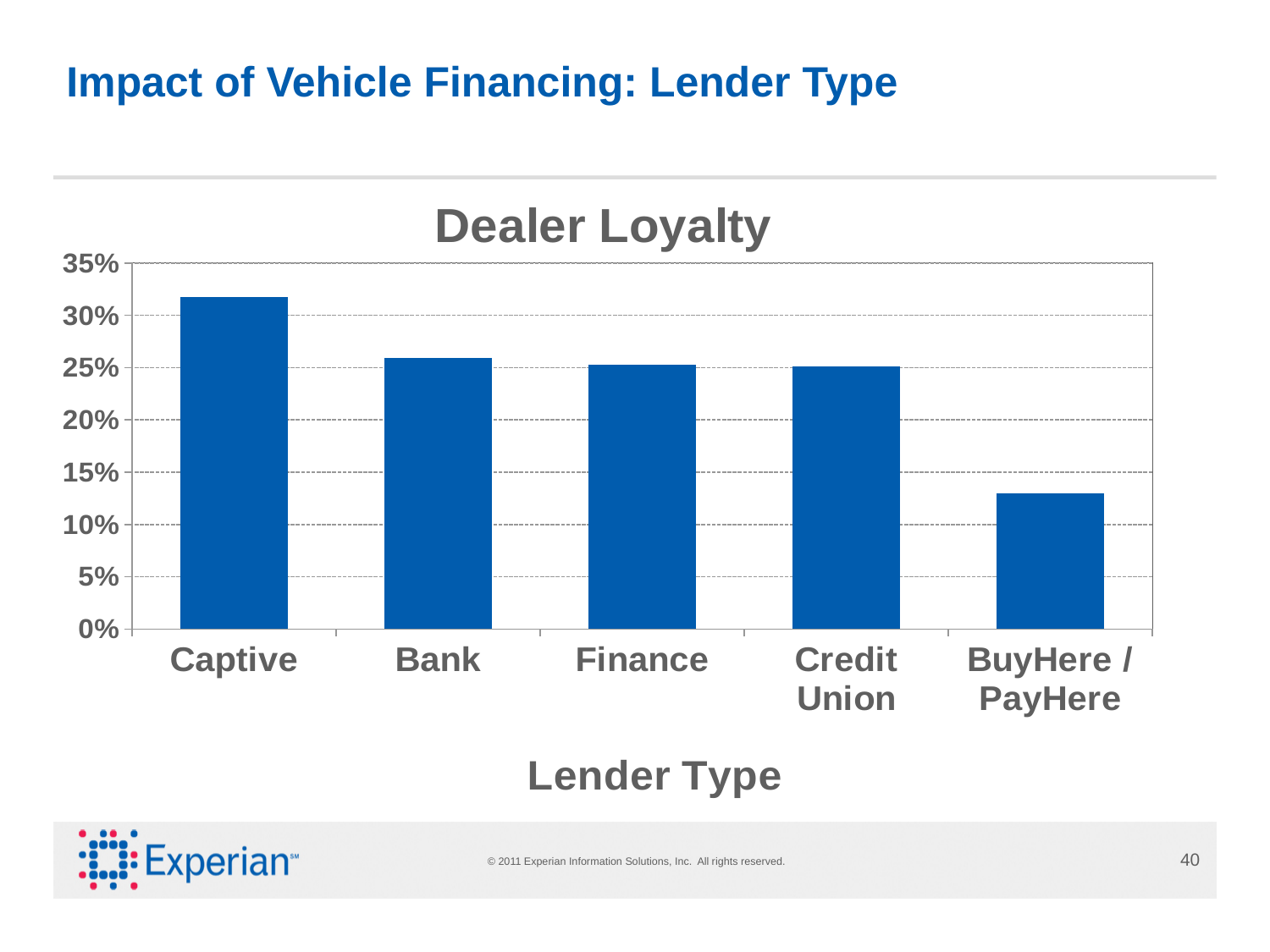
Is the value for Captive greater or less than 30%? greater Which has higher dealer loyalty, Bank or BuyHere / PayHere? Bank Which has higher dealer loyalty, Captive or Bank? Captive Which lender type has the lowest dealer loyalty? BuyHere / PayHere Which lender type has the highest dealer loyalty? Captive Do the values generally rise or fall moving from Captive to BuyHere / PayHere along the x axis? fall Is the value for BuyHere / PayHere greater or less than 15%? less Is the value for Finance greater or less than 20%? greater What is the title of the chart? Dealer Loyalty What is the x-axis title of the chart? Lender Type How many lender types are shown in the chart? 5 What kind of chart is shown on the slide? bar chart